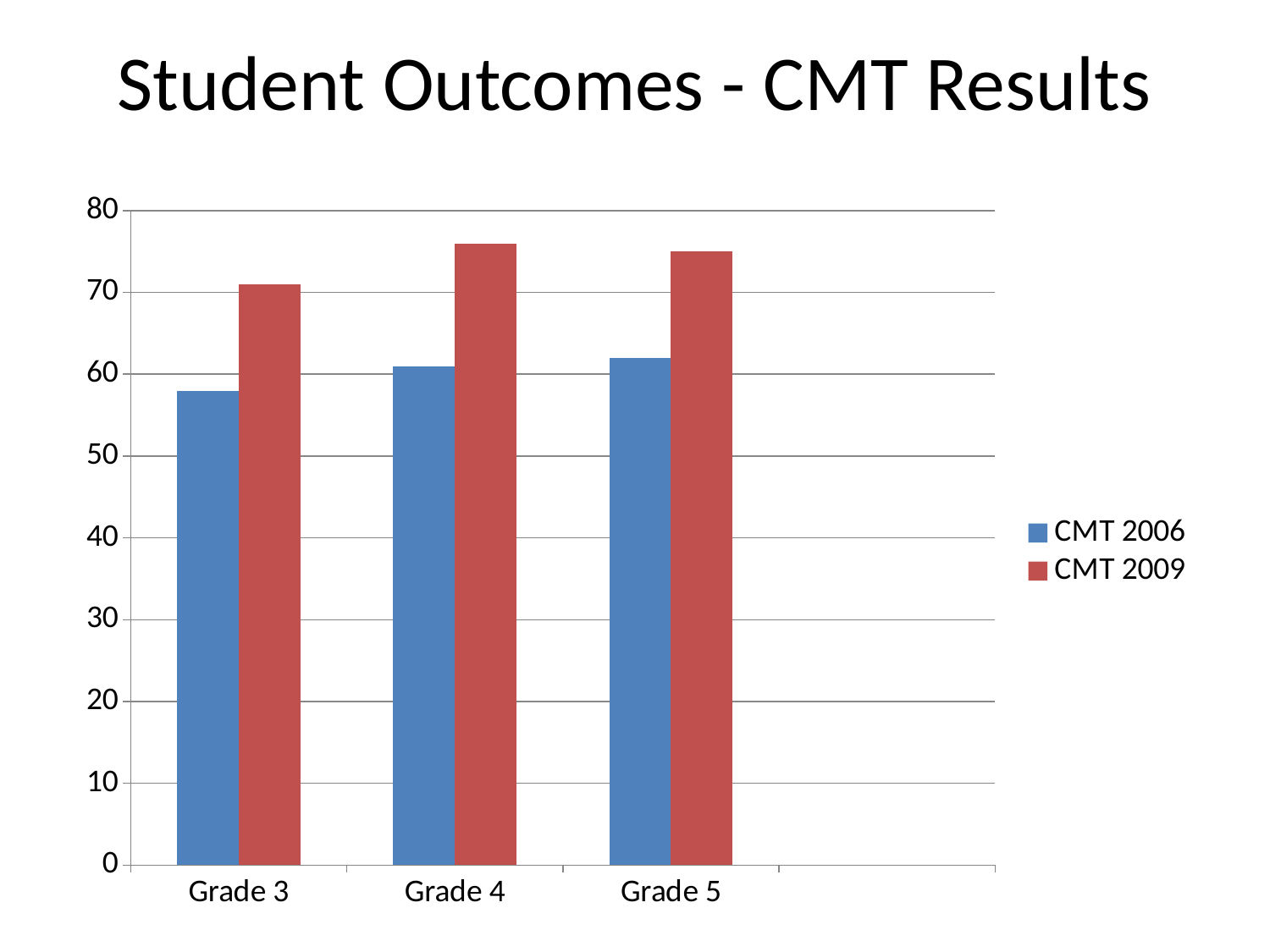
How many grade categories are shown on the x axis? 3 How many series does the legend list? 2 Do the CMT 2006 values rise or fall from Grade 3 to Grade 5? rise Which grade has the lowest CMT 2006 value? Grade 3 Which grade has the lowest CMT 2009 value? Grade 3 Is the CMT 2006 value for Grade 3 greater or less than 60? less What kind of chart is shown on the slide? bar chart Is the CMT 2009 value for Grade 4 greater or less than 70? greater Is the CMT 2009 value for Grade 5 greater or less than 80? less What is the title of the chart slide? Student Outcomes - CMT Results For Grade 3, which is larger: the CMT 2006 value or the CMT 2009 value? CMT 2009